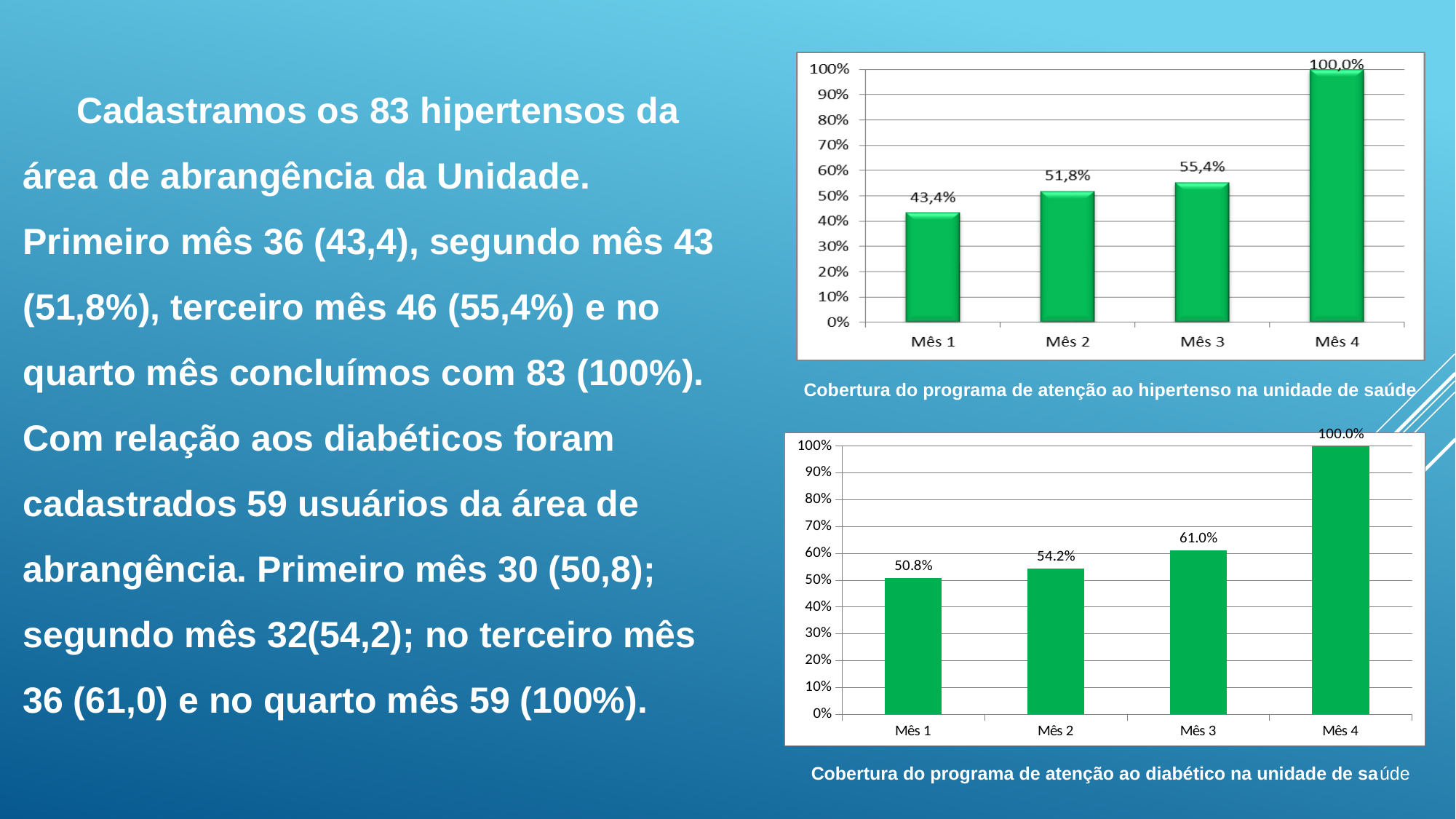
In the top chart (Cobertura do programa de atenção ao hipertenso), which is larger: the value for Mês 2 or the value for Mês 3? Mês 3 In the top chart (Cobertura do programa de atenção ao hipertenso), what is the value for Mês 1? 43,4% How many months (categories) are shown in the bottom chart (Cobertura do programa de atenção ao diabético)? 4 In the bottom chart (Cobertura do programa de atenção ao diabético), what is the value for Mês 2? 54.2% In the top chart (Cobertura do programa de atenção ao hipertenso), which month has the lowest value? Mês 1 In the top chart (Cobertura do programa de atenção ao hipertenso), is the value for Mês 1 greater or less than 50%? less In the bottom chart (Cobertura do programa de atenção ao diabético), do the values rise or fall from Mês 1 to Mês 4? Rise In the top chart (Cobertura do programa de atenção ao hipertenso), what is the value for Mês 3? 55,4% In the bottom chart (Cobertura do programa de atenção ao diabético), which month has the highest value? Mês 4 In the bottom chart (Cobertura do programa de atenção ao diabético), what is the value for Mês 3? 61.0% In the bottom chart (Cobertura do programa de atenção ao diabético), what is the difference between the values for Mês 3 and Mês 1? 10.2% What type of chart is the top chart (Cobertura do programa de atenção ao hipertenso)? Bar chart